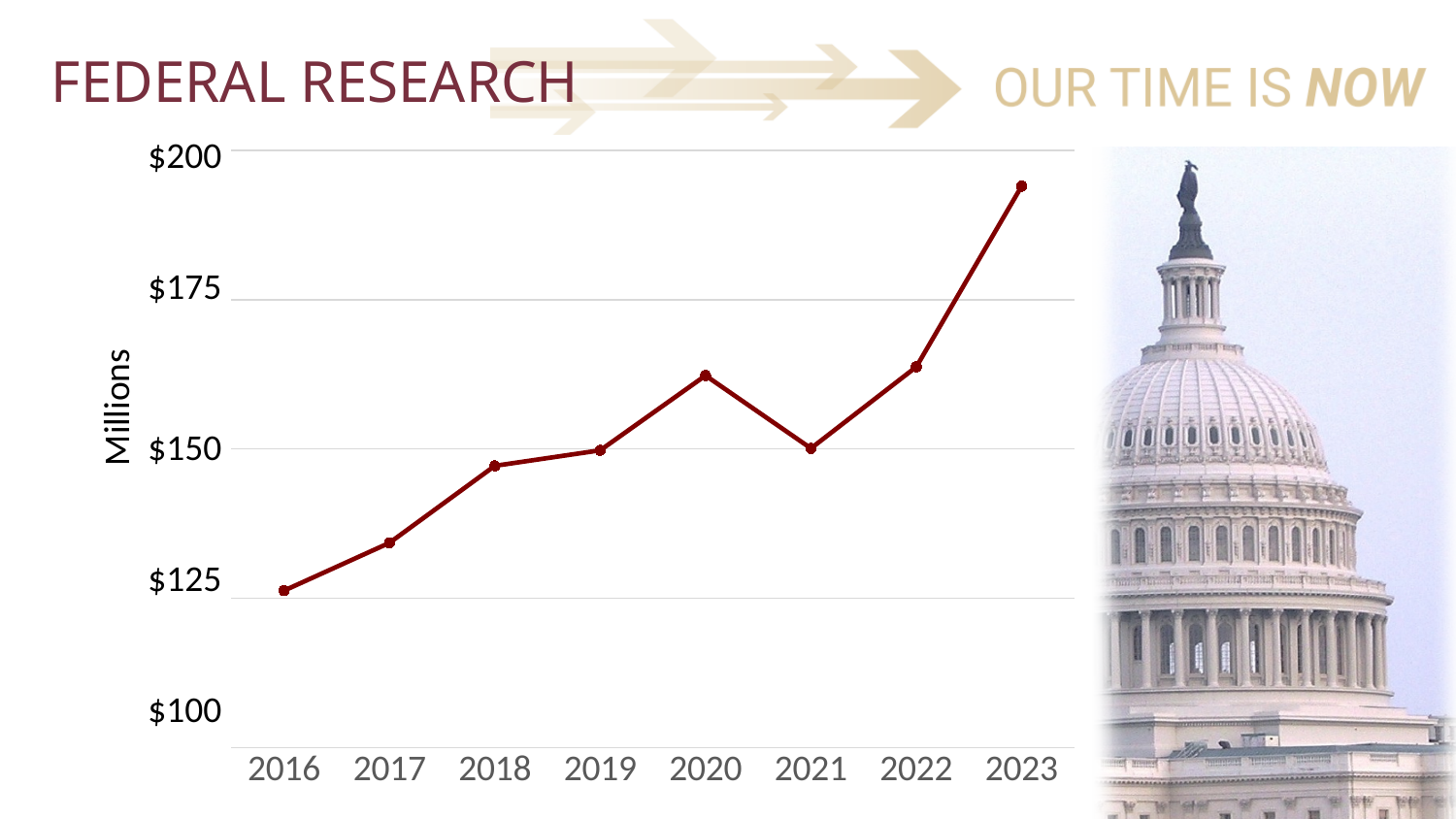
Is the value for 2023 greater or less than $175? greater Which year has the larger value, 2020 or 2021? 2020 Which year has the larger value, 2017 or 2018? 2018 Does the value rise or fall from 2020 to 2021? fall Is the value for 2018 greater or less than $150? less Which year has the highest federal research value? 2023 What is the label on the vertical axis of the chart? Millions Is the value for 2020 greater or less than $150? greater How many years are plotted on the x axis of the chart? 8 Which year has the lowest federal research value? 2016 What kind of chart is shown on the slide? line chart